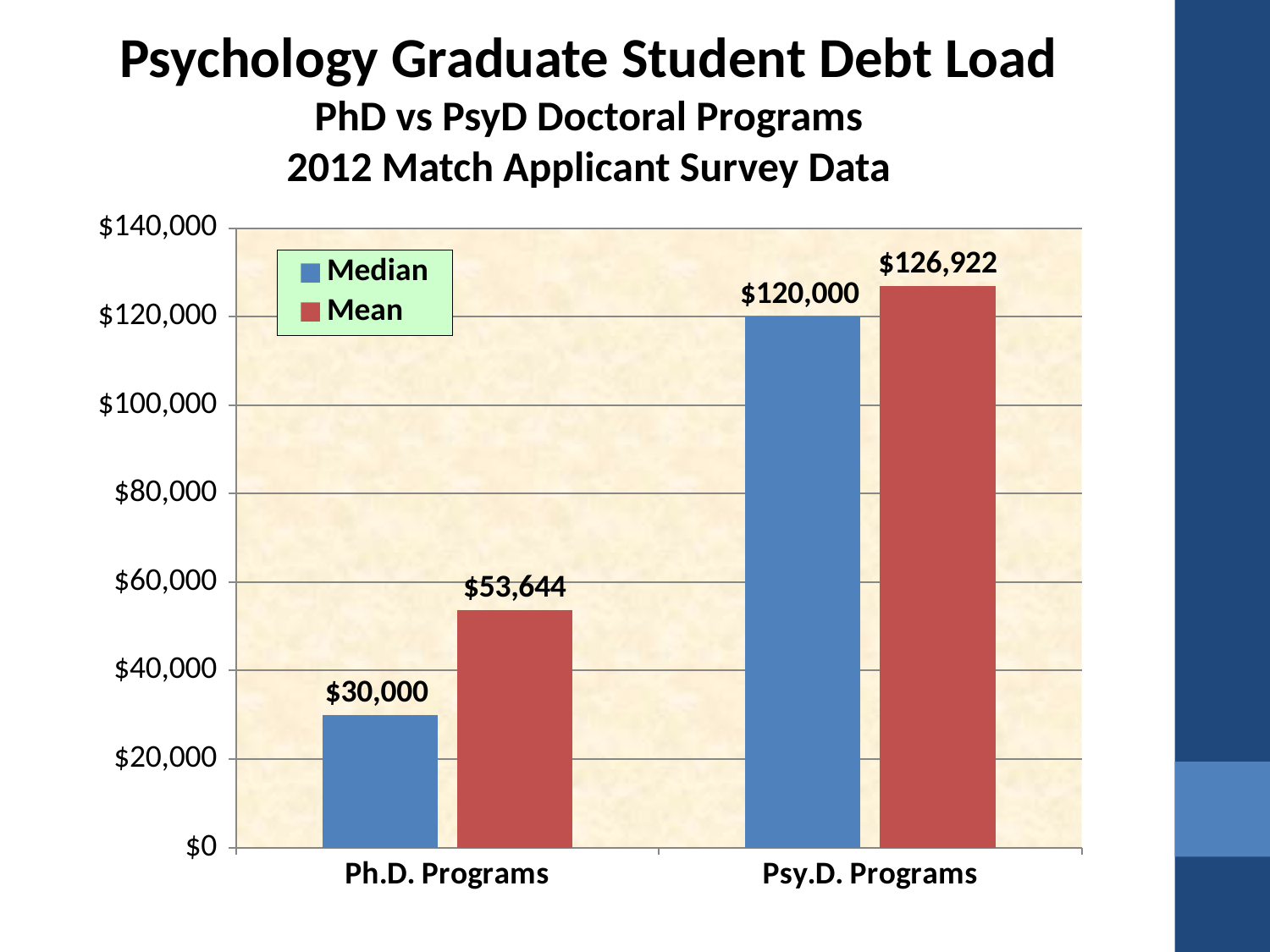
Is the Mean debt load for Ph.D. Programs larger or smaller than the Median debt load for Psy.D. Programs? smaller What is the Median debt load for Ph.D. Programs? $30,000 Which program type has the lowest Median debt load? Ph.D. Programs What is the Mean debt load for Ph.D. Programs? $53,644 What is the difference between the Mean and Median debt load for Ph.D. Programs? $23,644 How many series does the legend list? 2 Which colour represents the Mean series in the chart? red Which program type has the highest Mean debt load? Psy.D. Programs What is the Median debt load for Psy.D. Programs? $120,000 What is the Mean debt load for Psy.D. Programs? $126,922 What kind of chart is shown on the slide? bar chart What is the difference between the Median debt load for Psy.D. Programs and Ph.D. Programs? $90,000